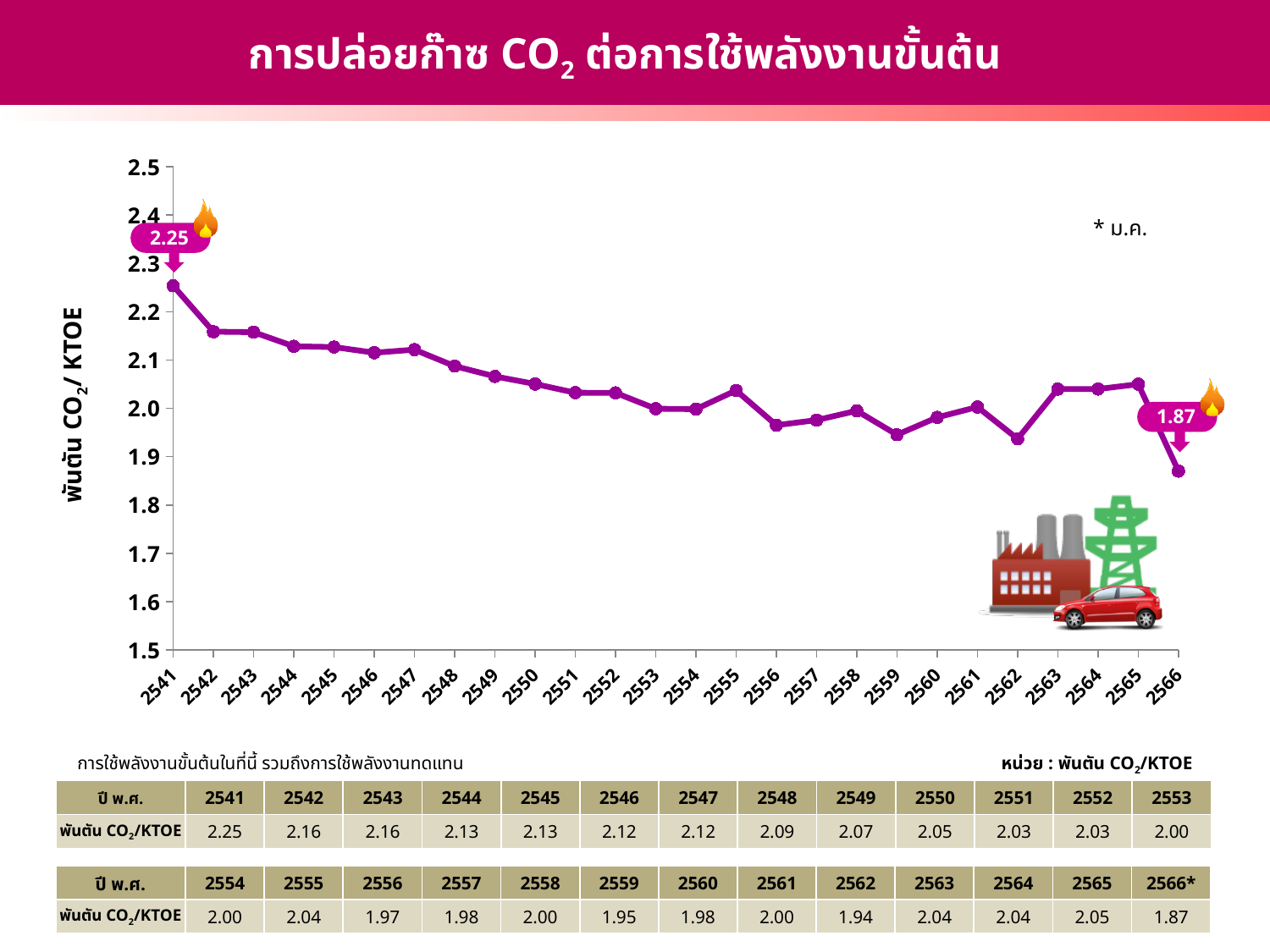
How many years are plotted on the x axis? 26 What is the value for the year 2566? 1.87 What is the difference between the values for 2541 and 2566? 0.38 What is the y-axis label of the chart? พันตัน CO2/ KTOE Is the value for 2566 greater or less than 1.9? less What kind of chart is shown on the slide? line chart Which is larger, the value for 2555 or the value for 2556? 2555 Do the values generally rise or fall from 2541 to 2566? fall Which year has the highest value? 2541 Which year has the lowest value? 2566 What is the value for the year 2562? 1.94 What is the value for the year 2541? 2.25